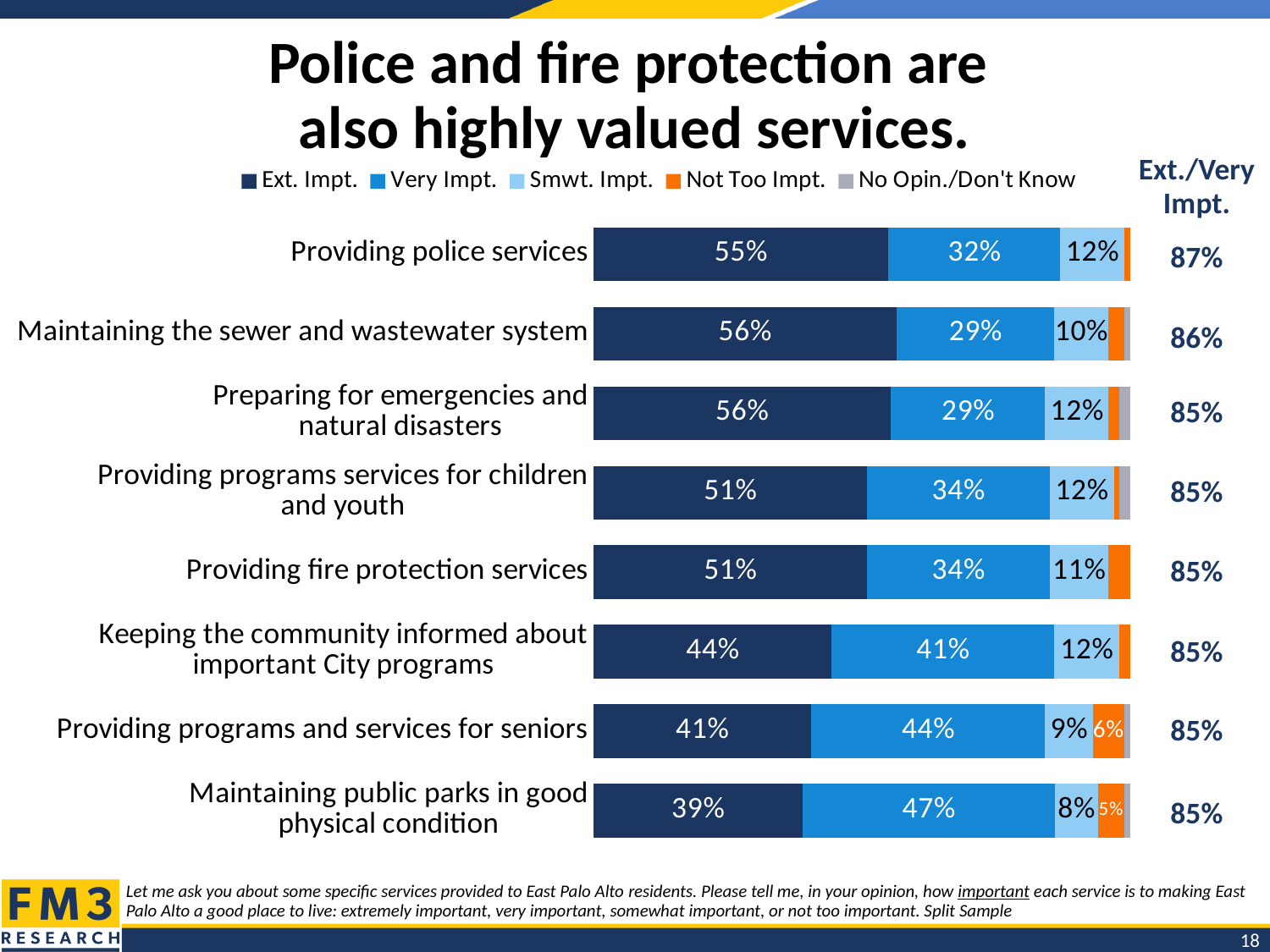
What is the Smwt. Impt. value for Providing programs and services for seniors? 9% Which category has the lowest Ext. Impt. value? Maintaining public parks in good physical condition What is the Very Impt. value for Maintaining public parks in good physical condition? 47% How many series does the legend list? 5 How many service categories are plotted in the chart? 8 What is the difference between the Ext. Impt. values for Providing police services and Providing fire protection services? 4% Which is larger: the Very Impt. value for Keeping the community informed about important City programs or for Providing fire protection services? Keeping the community informed about important City programs What is the Ext. Impt. value for Providing police services? 55% What is the Ext./Very Impt. combined value shown for Maintaining the sewer and wastewater system? 86% What kind of chart is shown on the slide? Stacked bar chart Which category has the highest Very Impt. value? Maintaining public parks in good physical condition Which legend entry is shown in orange? Not Too Impt.